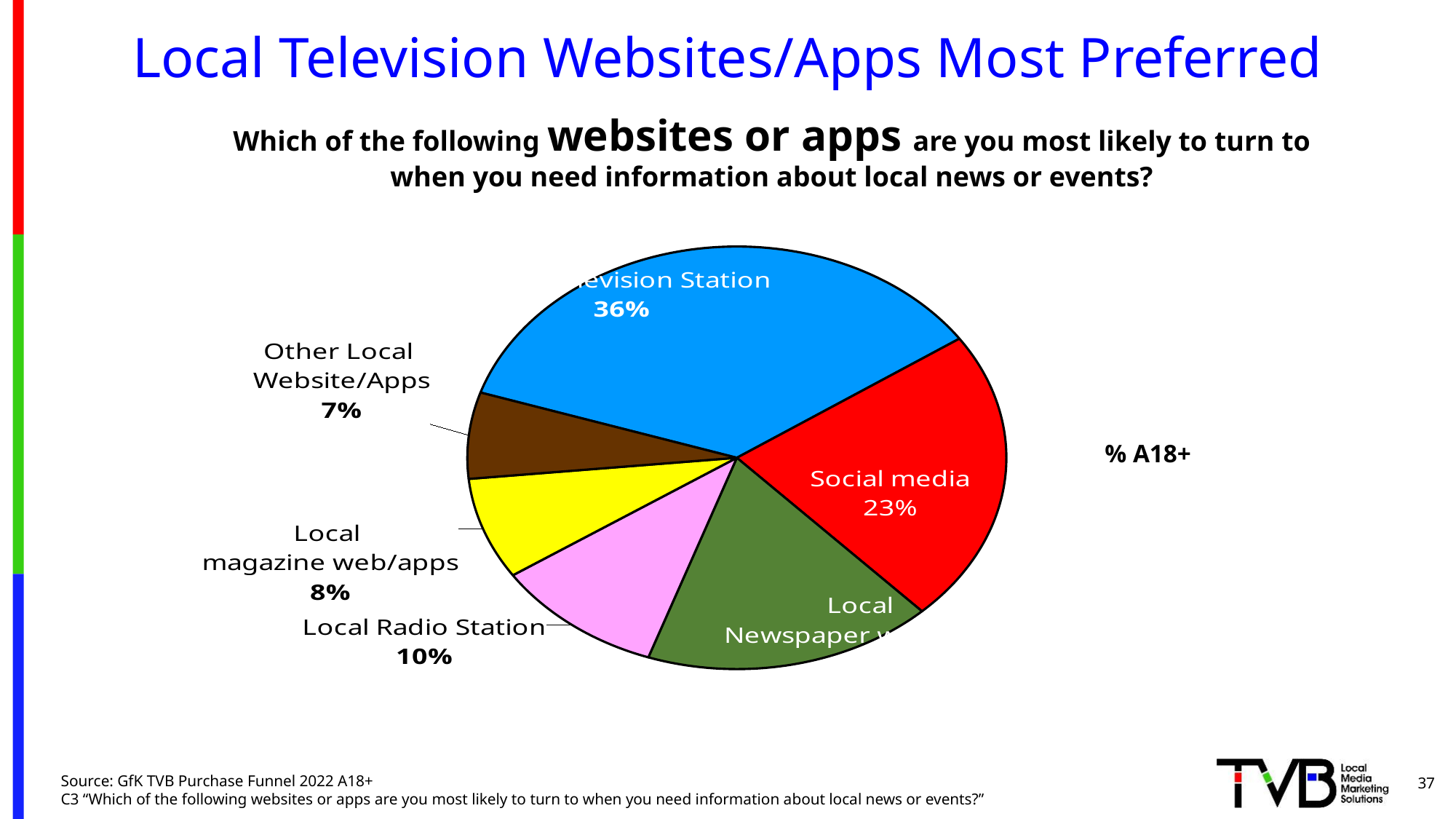
Which slice of the pie chart is the largest? Television Station (36%) What share does Local Radio Station have in the pie chart? 10% Which is larger, the Local magazine web/apps slice or the Other Local Website/Apps slice? Local magazine web/apps Which category has the smallest share in the pie chart? Other Local Website/Apps (7%) Which slice is larger, Local Newspaper or Local Radio Station? Local Newspaper What colour is the Social media slice? Red What type of chart is shown on the slide? Pie chart What is the value shown for Local magazine web/apps? 8% How many slices does the pie chart have? 6 What percentage is shown for Other Local Website/Apps? 7% How many percentage points larger is Social media than Local Radio Station? 13 percentage points What percentage of the pie is Social media? 23%